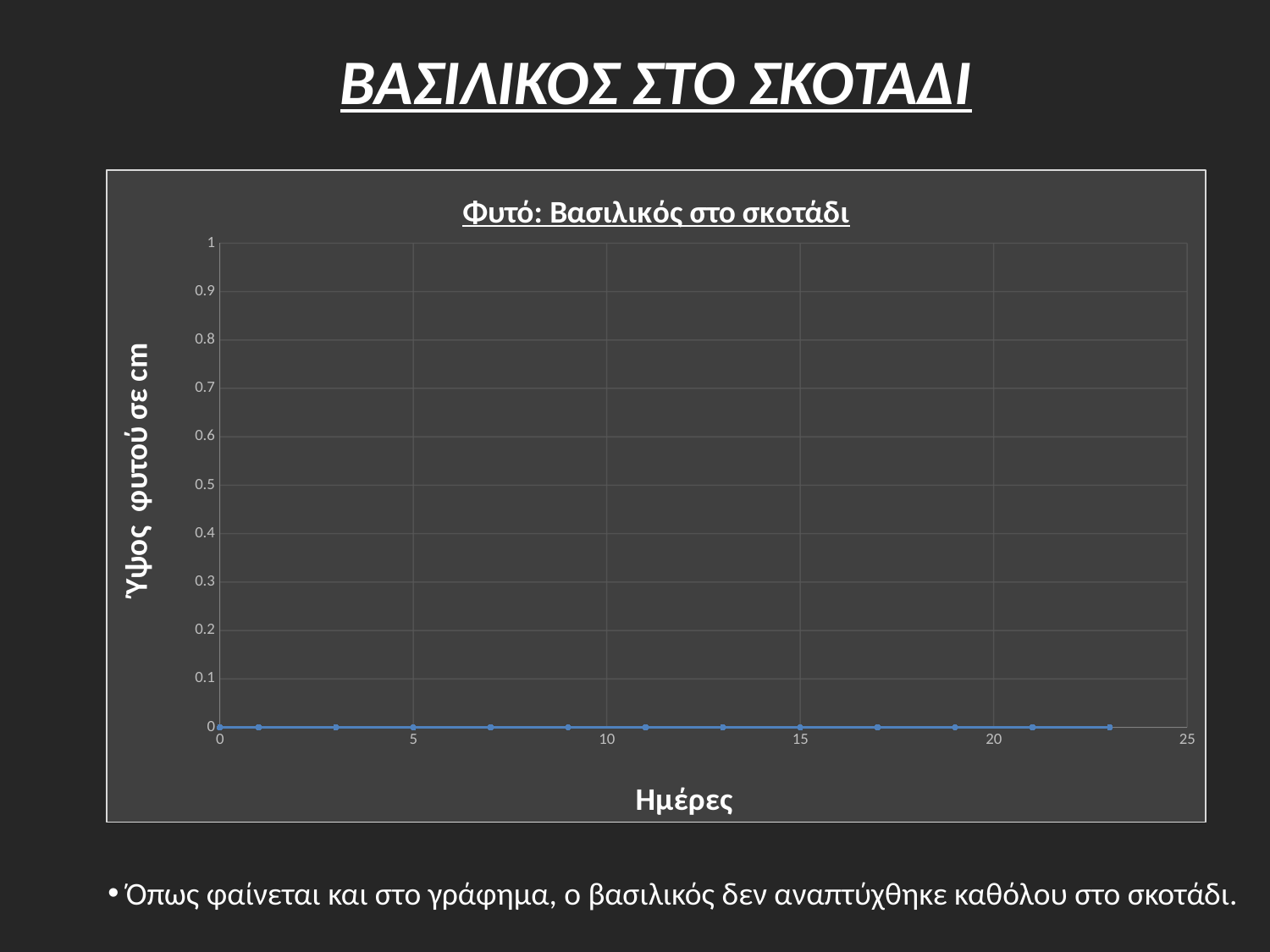
What is the label of the vertical axis? Ύψος φυτού σε cm Do the plotted values rise, fall, or stay flat as the days increase? stay flat What is the difference between the plant height on day 20 and on day 0? 0 What kind of chart is shown on the slide? line chart What is the title of the chart? Φυτό: Βασιλικός στο σκοτάδι What is the maximum value shown on the vertical axis? 1 How many data points are plotted on the line? 13 Is the plant height on day 10 greater or less than 0.5 cm? less What is the plant height in cm on day 15? 0 What is the plant height in cm on day 0? 0 What is the highest value reached by the plotted line? 0 What is the plant height in cm on day 5? 0